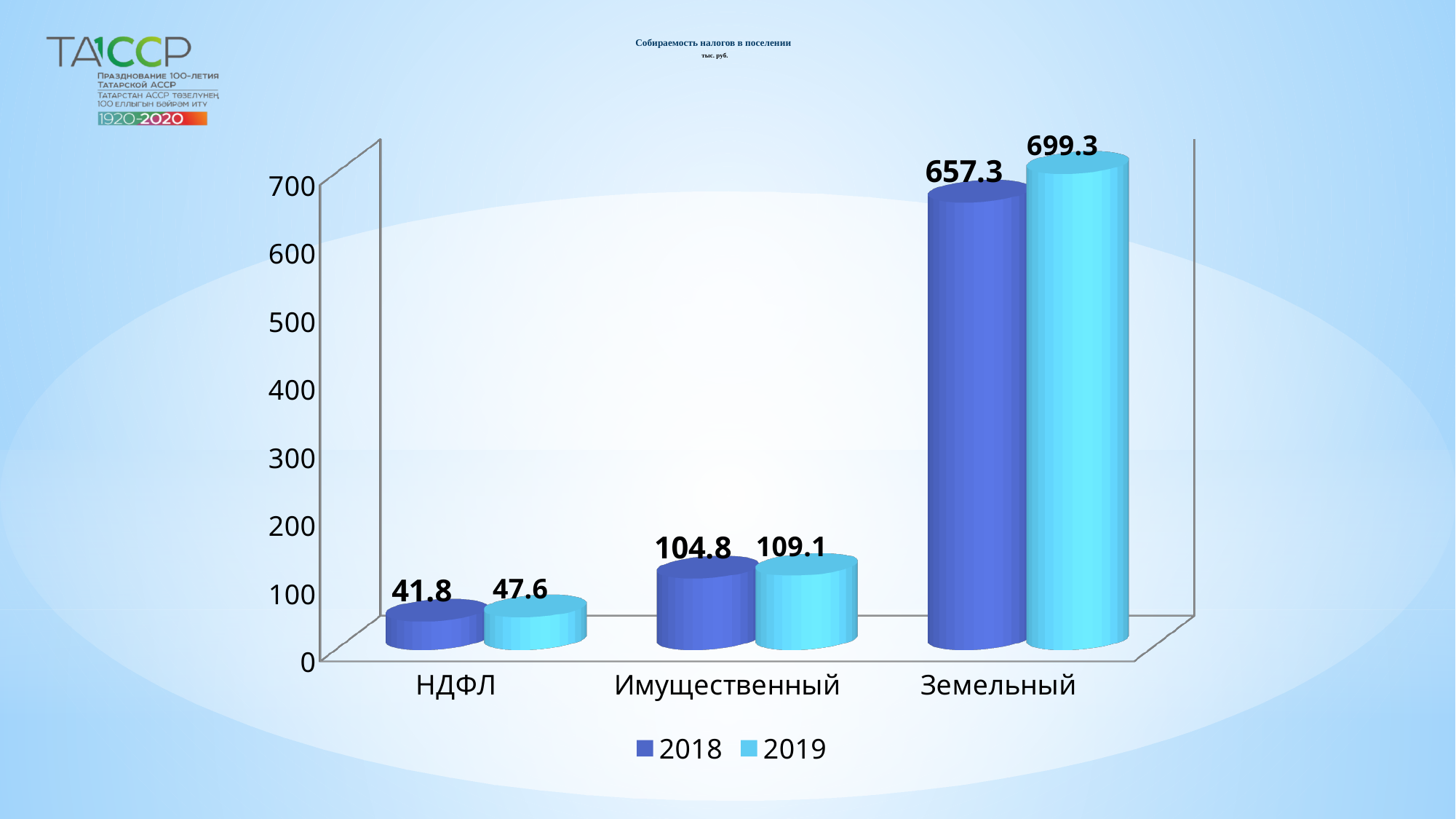
What kind of chart is shown on the slide? Bar chart How many series does the legend list? 2 What is the value for НДФЛ in 2018? 41.8 How many categories are shown on the x axis? 3 Which category has the lowest value in 2018? НДФЛ What is the value for Земельный in 2019? 699.3 What is the difference between the 2019 and 2018 values for НДФЛ? 5.8 Which category has the highest value in 2019? Земельный What is the value for Имущественный in 2019? 109.1 What is the title of the chart? Собираемость налогов в поселении What is the difference between the 2019 and 2018 values for Земельный? 42.0 Which is larger for Имущественный: the 2018 value or the 2019 value? 2019